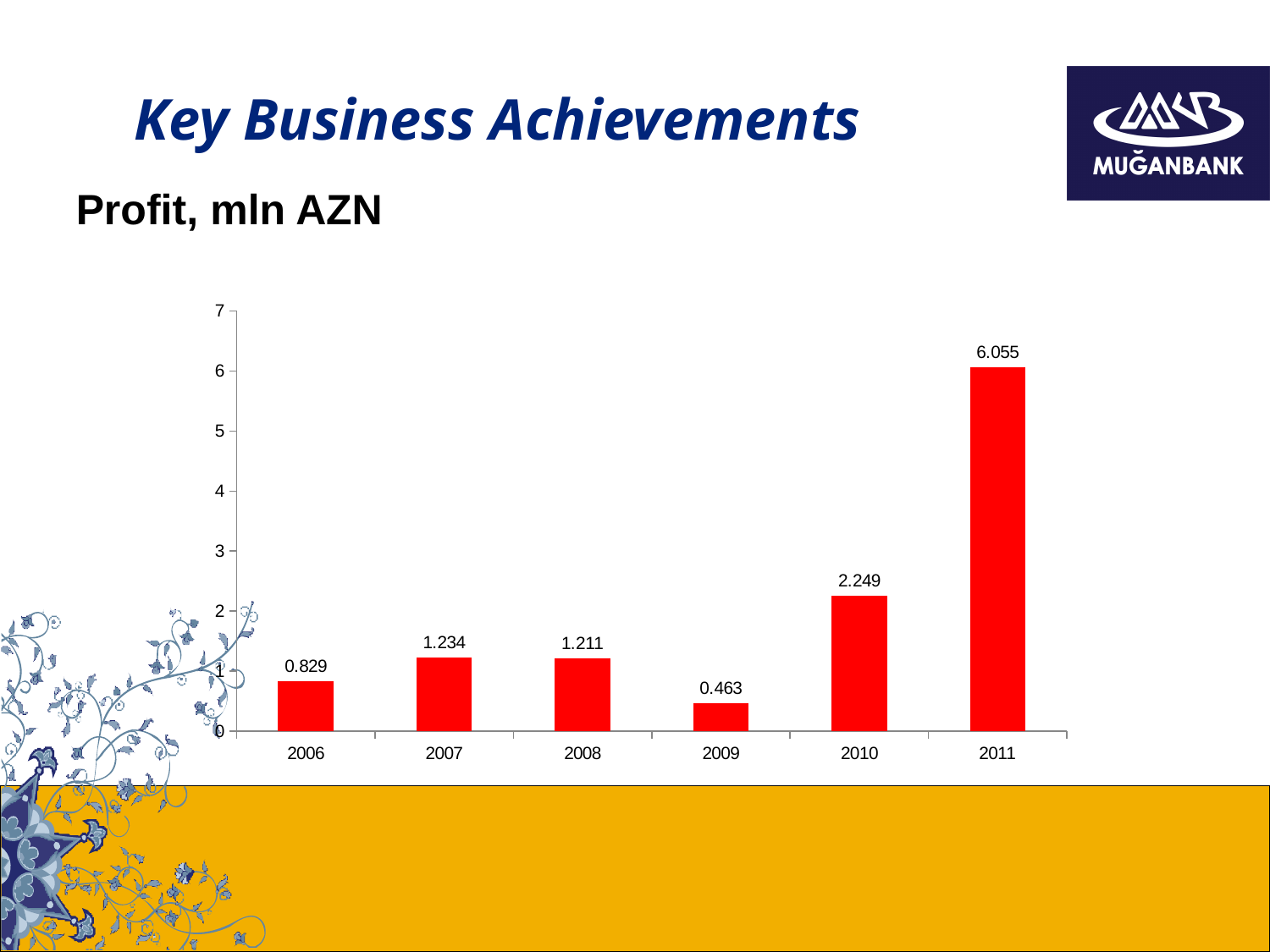
What is the profit value shown for 2011? 6.055 What is the title of the chart? Profit, mln AZN Is the profit for 2010 greater or less than 2? greater How many years are shown on the chart? 6 What is the difference between the profit in 2011 and the profit in 2010? 3.806 What is the profit value shown for 2006? 0.829 Which year has the highest profit? 2011 What is the profit value shown for 2009? 0.463 What is the difference between the profit in 2007 and the profit in 2008? 0.023 What kind of chart is shown on the slide? bar chart Which year has the lowest profit? 2009 Which year has the larger profit, 2006 or 2010? 2010